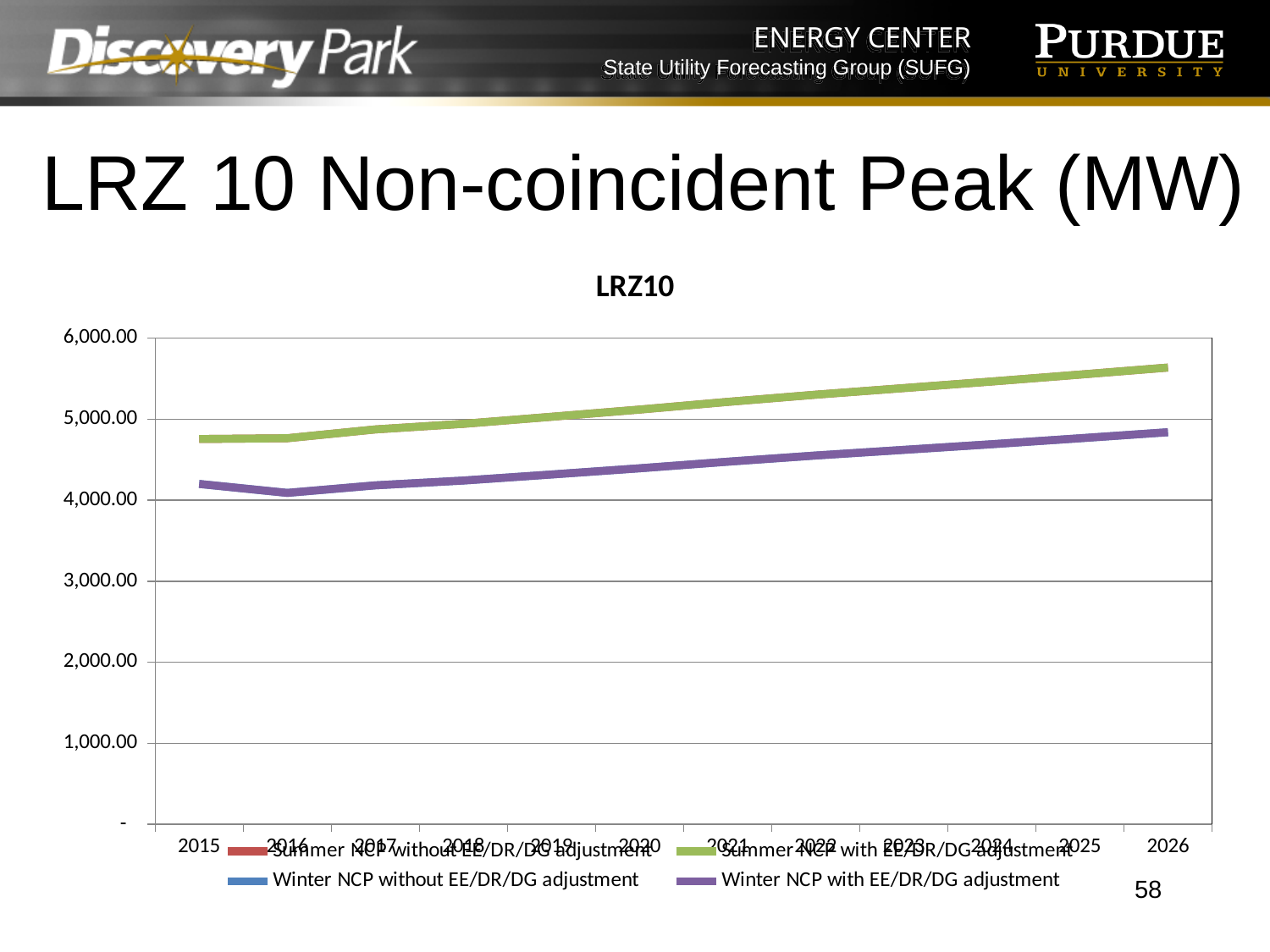
In 2026, which is larger: Summer NCP with EE/DR/DG adjustment or Winter NCP with EE/DR/DG adjustment? Summer NCP with EE/DR/DG adjustment Is the value for Winter NCP with EE/DR/DG adjustment in 2026 greater or less than 5,000.00? less Is the value for Summer NCP with EE/DR/DG adjustment in 2015 greater or less than 5,000.00? less What kind of chart is shown on the slide? line chart In which year is the Summer NCP with EE/DR/DG adjustment value highest? 2026 What is the first year shown on the x axis? 2015 Is the value for Summer NCP with EE/DR/DG adjustment in 2026 greater or less than 5,000.00? greater How many series does the legend list? 4 How many years are shown along the x axis? 12 Does the Summer NCP with EE/DR/DG adjustment line rise or fall from 2015 to 2026? rise Does the Winter NCP with EE/DR/DG adjustment line rise or fall from 2016 to 2026? rise What is the title of the chart? LRZ10